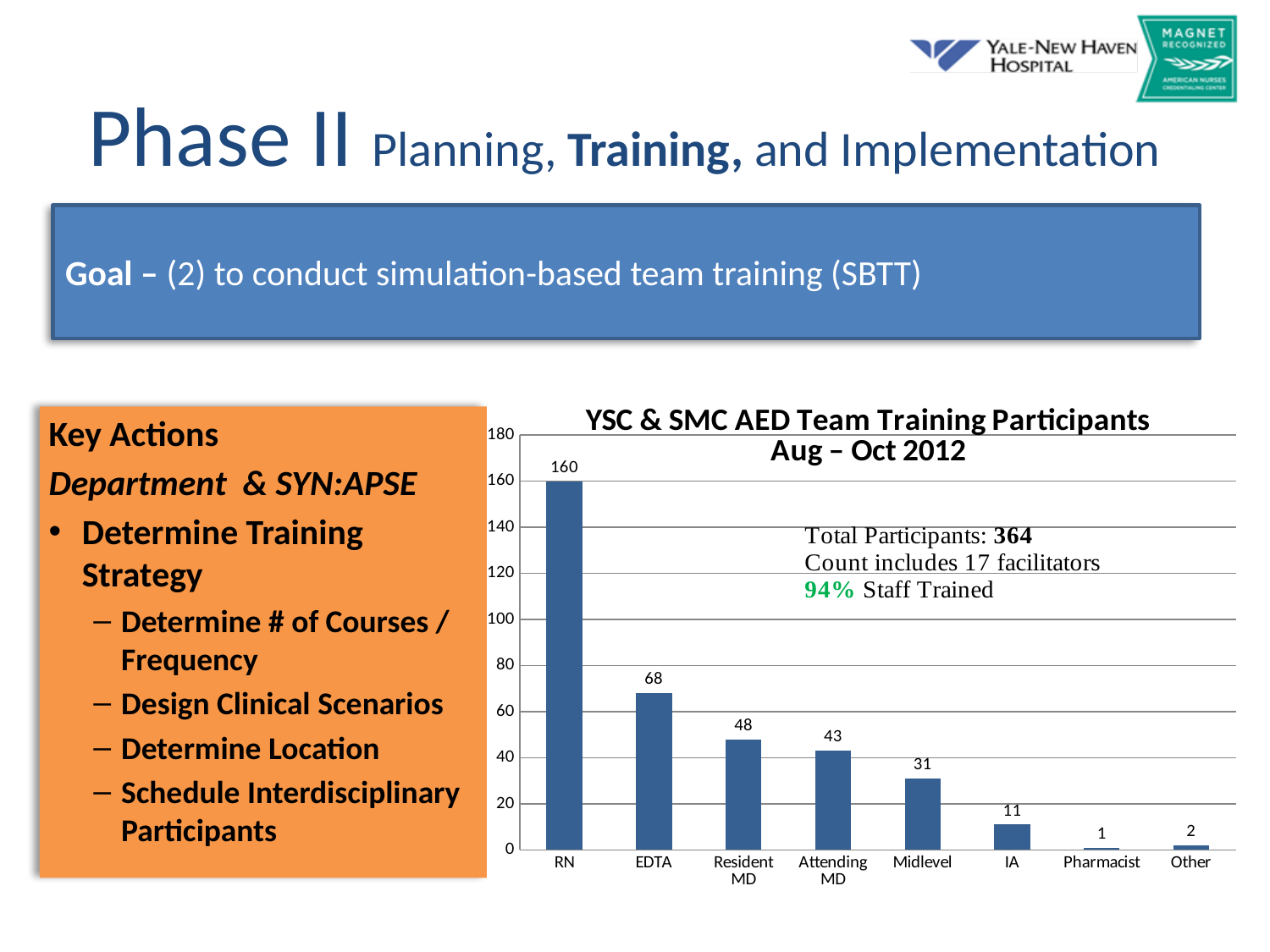
Which is larger, the value for IA or the value for Other? IA What is the value shown for EDTA? 68 How many categories are shown on the x axis of the chart? 8 Which category has the highest number of participants? RN What is the title of the chart? YSC & SMC AED Team Training Participants Aug – Oct 2012 What is the difference between the values for RN and EDTA? 92 How many participants does the chart show for RN? 160 Which category has the lowest number of participants? Pharmacist What is the difference between the values for Resident MD and Attending MD? 5 What is the value shown for Pharmacist? 1 What is the value shown for Midlevel? 31 What kind of chart is shown on the slide? Bar chart